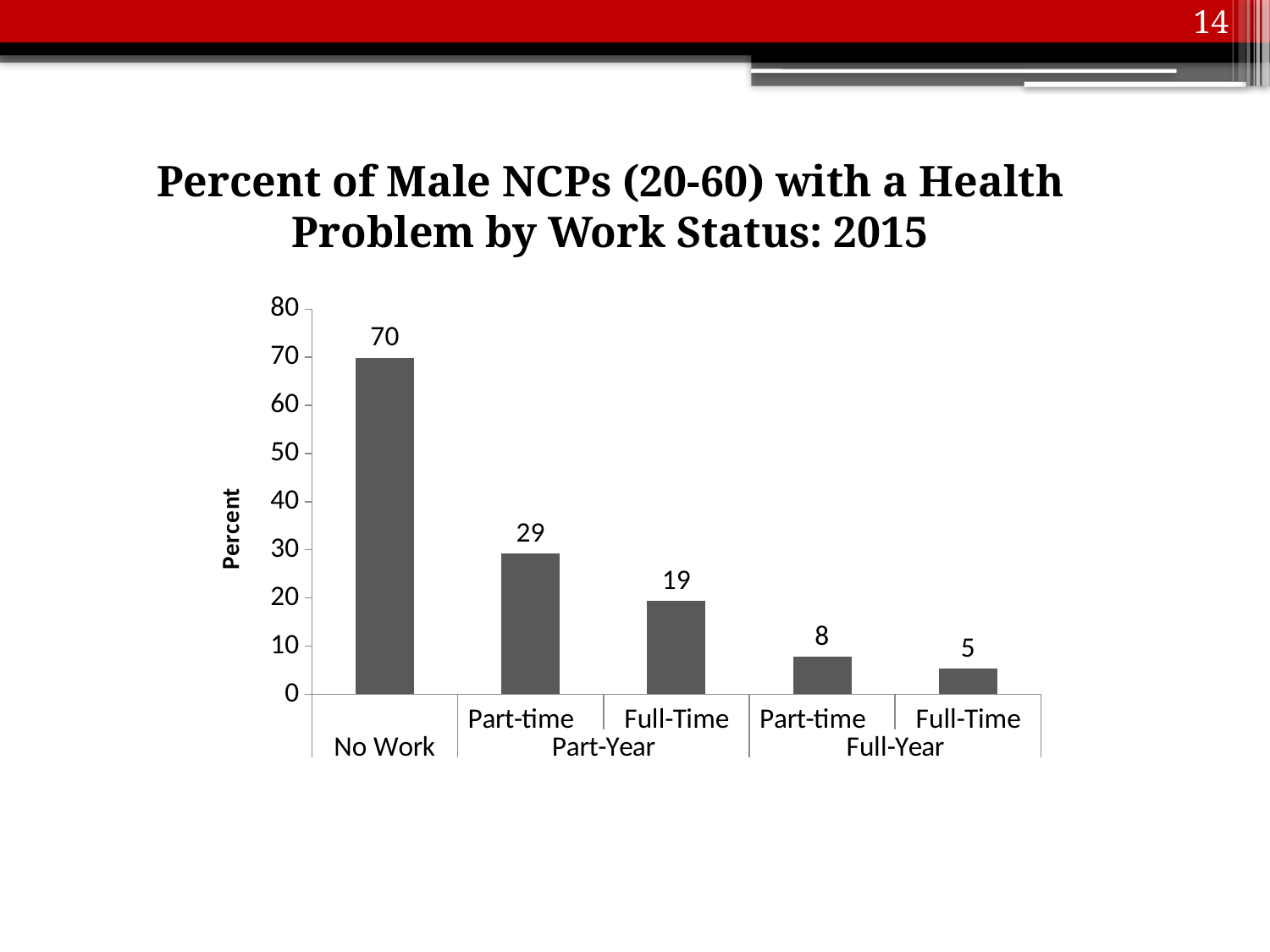
How many bars are shown in the chart? 5 What is the difference between the No Work value and the Part-Year Part-time value? 41 Which work status category has the lowest percent with a health problem? Full-Year Full-Time What is the percent of male NCPs with a health problem for the No Work category? 70 What is the label of the vertical axis? Percent What is the difference between the Part-Year Full-Time value and the Full-Year Full-Time value? 14 What type of chart is shown on the slide? bar chart Do the values rise or fall moving from left to right across the categories? fall Which work status category has the highest percent with a health problem? No Work What is the value for Part-Year Part-time workers? 29 Which is larger: the value for Part-Year Full-Time or Full-Year Part-time? Part-Year Full-Time What is the value for Full-Year Full-Time workers? 5